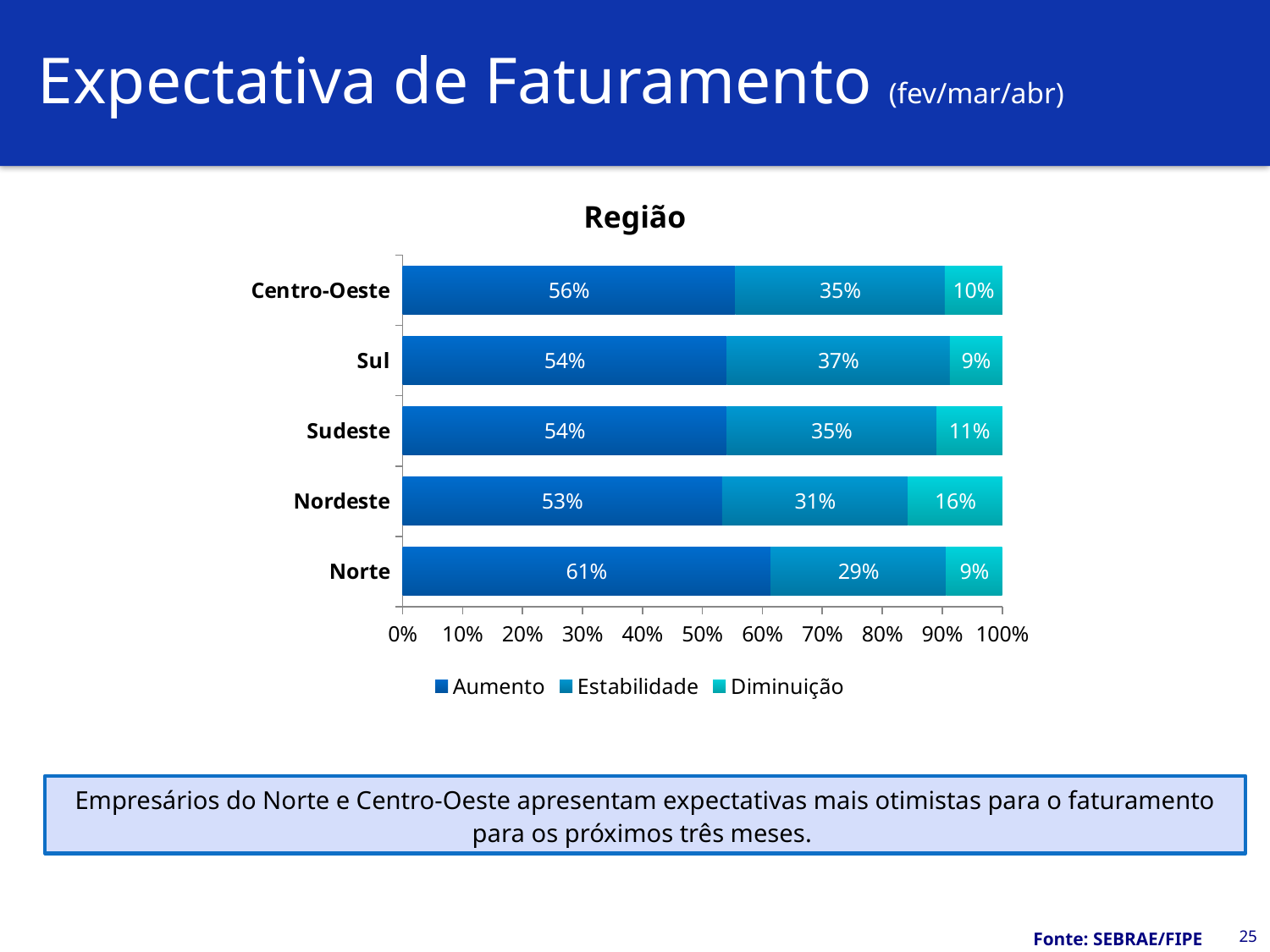
Which region has the highest Aumento value? Norte Which region has the lowest Aumento value? Nordeste What is the title of the chart? Região How many series does the legend list? 3 What is the Diminuição value for Nordeste? 16% What is the Estabilidade value for Sul? 37% What is the difference between the Aumento values for Norte and Nordeste? 8 percentage points What is the Aumento value for Norte? 61% What kind of chart is shown on the slide? Stacked bar chart Which has the larger Estabilidade value, Sul or Centro-Oeste? Sul How many regions are shown in the chart? 5 Which region has the highest Diminuição value? Nordeste